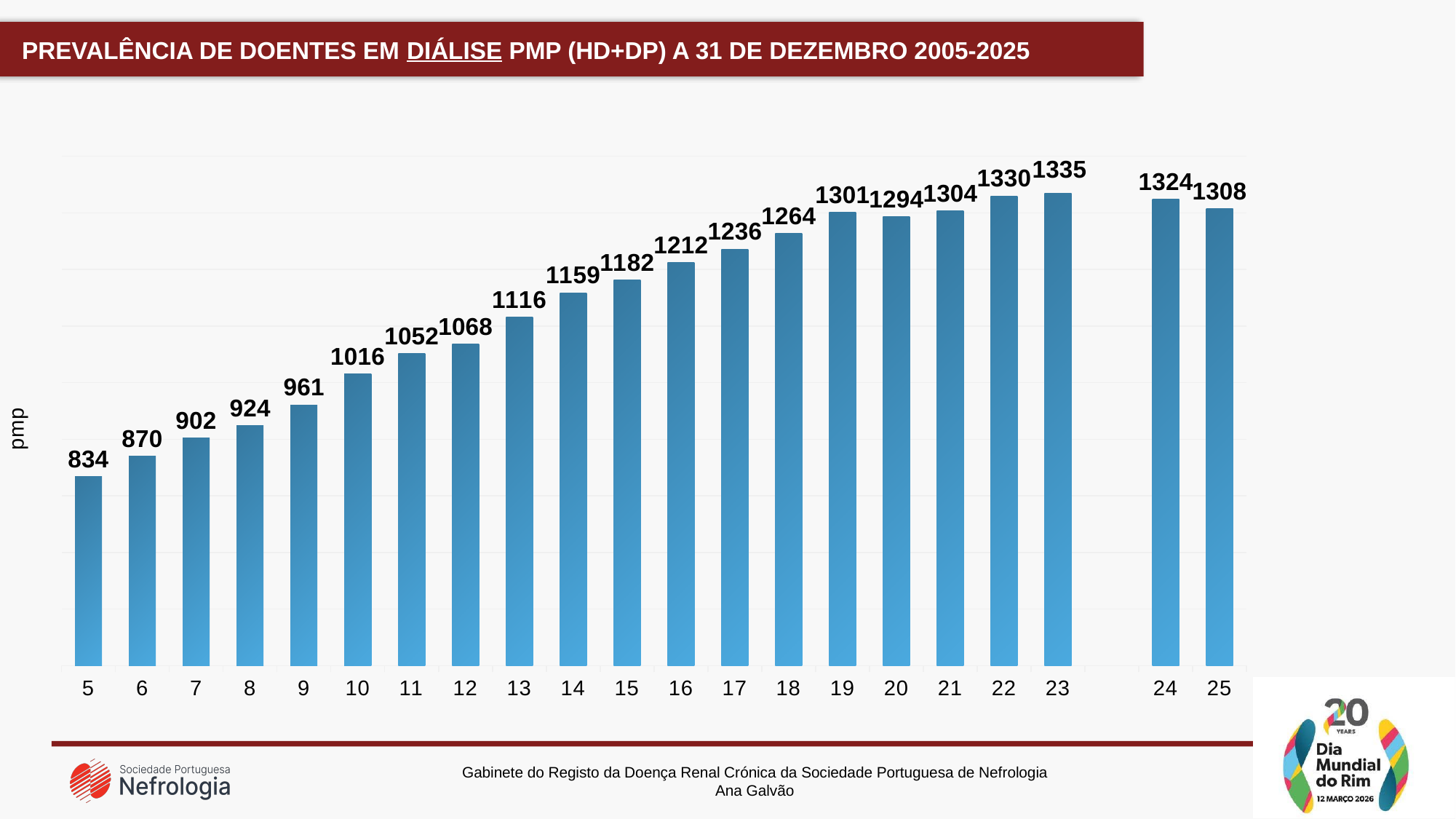
What is the label on the vertical axis? pmp What is the value for year 15? 1182 What is the difference between the values for year 25 and year 5? 474 Which year has the highest value? 23 What is the value for year 25? 1308 What is the difference between the values for year 23 and year 22? 5 Which is larger, the value for year 19 or the value for year 20? year 19 Do the values generally rise or fall from year 5 to year 23? rise What type of chart is shown on the slide? bar chart Which year has the lowest value? 5 How many bars are plotted in the chart? 21 What is the value for year 5 (2005)? 834